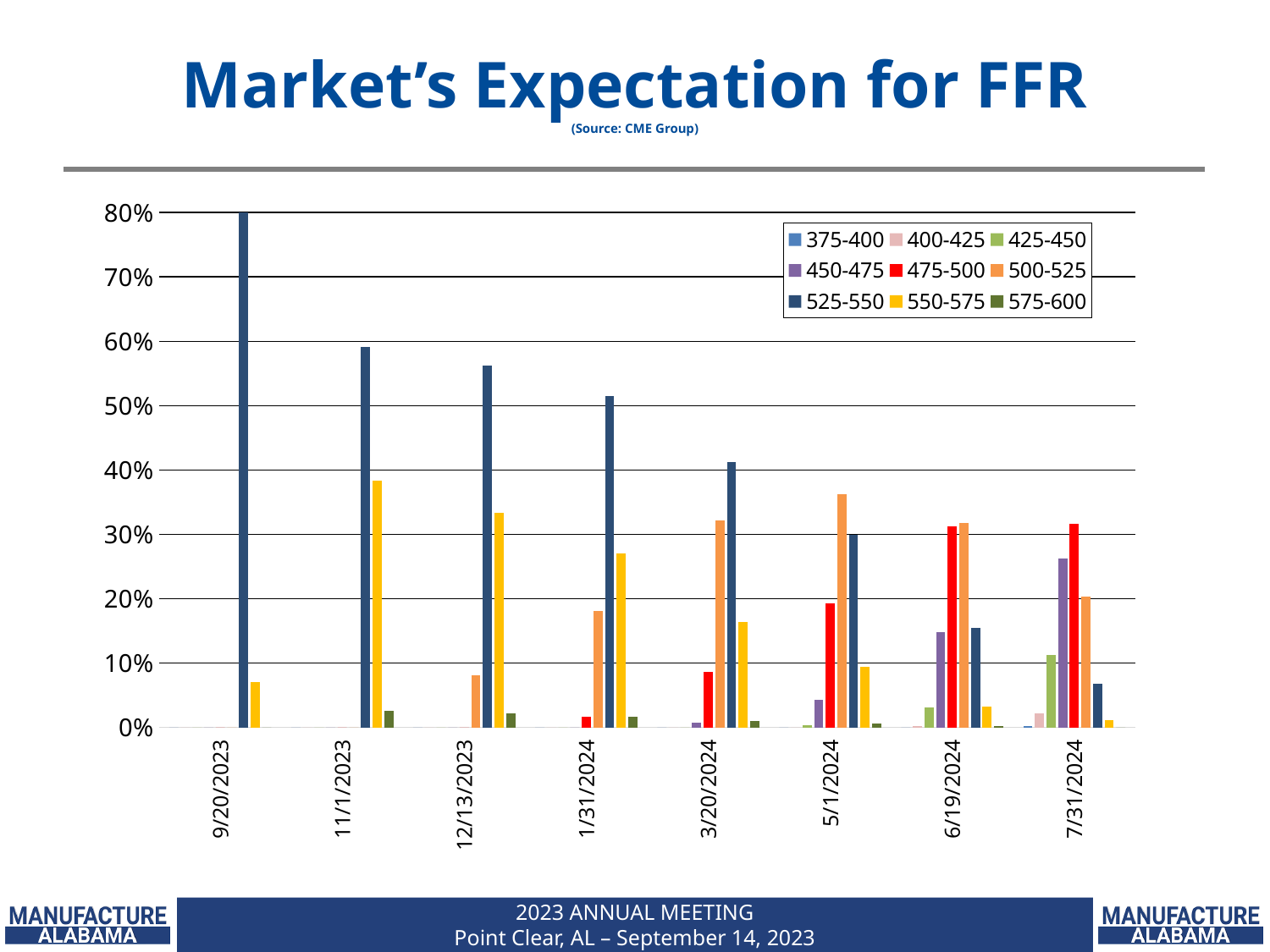
Does the value for the 525-550 series rise or fall from 9/20/2023 to 7/31/2024? fall Is the value for 525-550 on 11/1/2023 greater or less than 50%? greater Is the value for 550-575 on 9/20/2023 greater or less than 10%? less Is the value for 550-575 on 11/1/2023 greater or less than 30%? greater How many dates are shown along the x axis? 8 What is the title of the chart? Market's Expectation for FFR How many series does the legend list? 9 On 7/31/2024, which series has the highest value? 475-500 On 1/31/2024, which is larger: the value for 525-550 or the value for 550-575? 525-550 On 5/1/2024, which is larger: the value for 500-525 or the value for 525-550? 500-525 What kind of chart is shown on the slide? bar chart